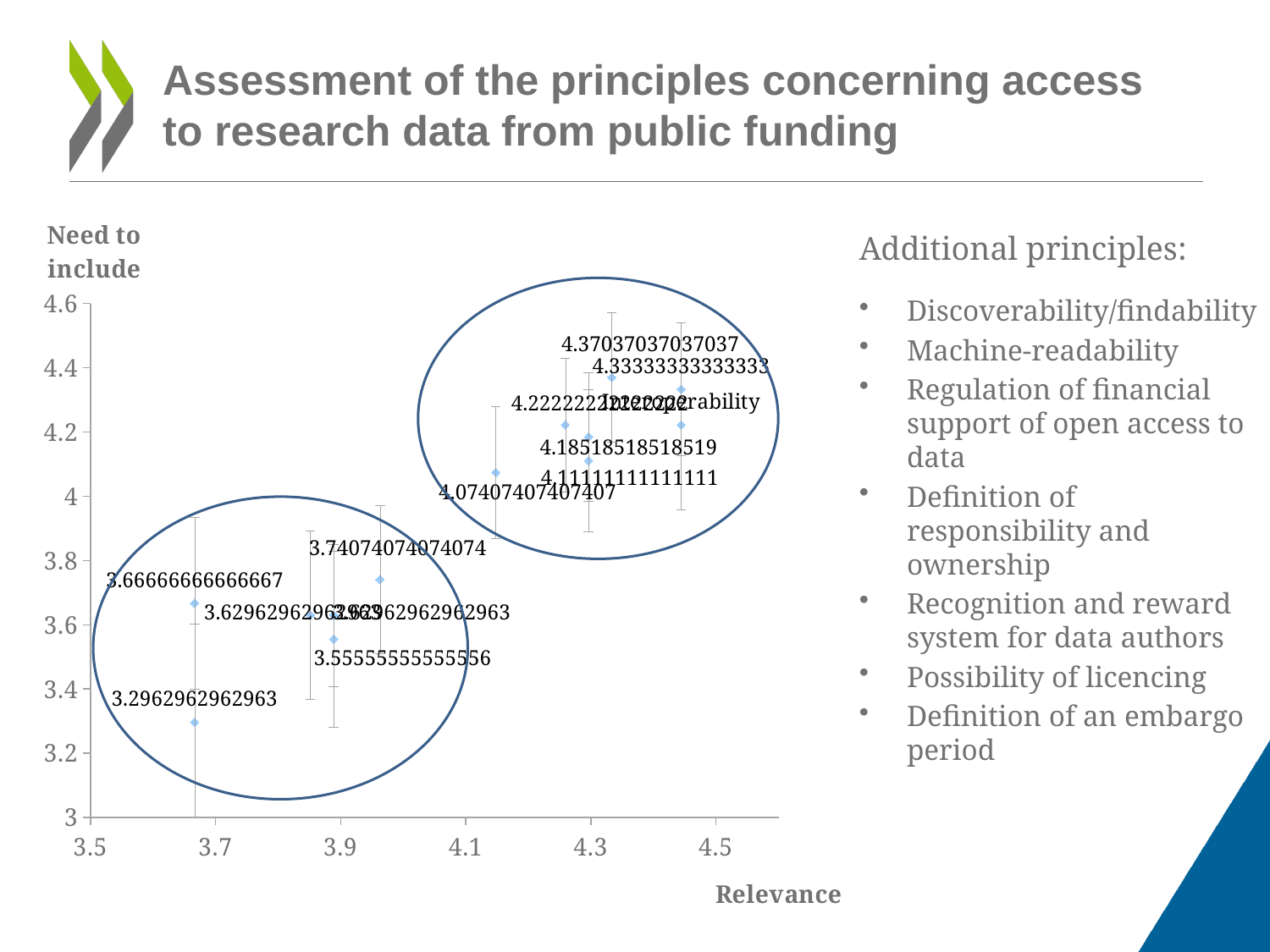
What is the lowest 'Need to include' value labelled on the chart? 3.2962962962963 What is the difference between the highest and lowest 'Need to include' values labelled on the chart? 1.07407407407407 Do the points on the chart generally rise or fall in 'Need to include' as Relevance increases along the x axis? rise What is the highest 'Need to include' value labelled on the chart? 4.37037037037037 Is the Relevance value of the point labelled 3.2962962962963 greater or less than 3.7? less Is the 'Need to include' value of the lowest point on the chart greater or less than 3.4? less What is the title of the horizontal axis of the chart? Relevance What is the title of the vertical axis of the chart? Need to include What kind of chart is shown on the slide? scatter chart Is the Relevance value of the point labelled 4.33333333333333 greater or less than 4.3? greater Which point has the higher 'Need to include' value: the one labelled 3.74074074074074 or the one labelled 3.55555555555556? 3.74074074074074